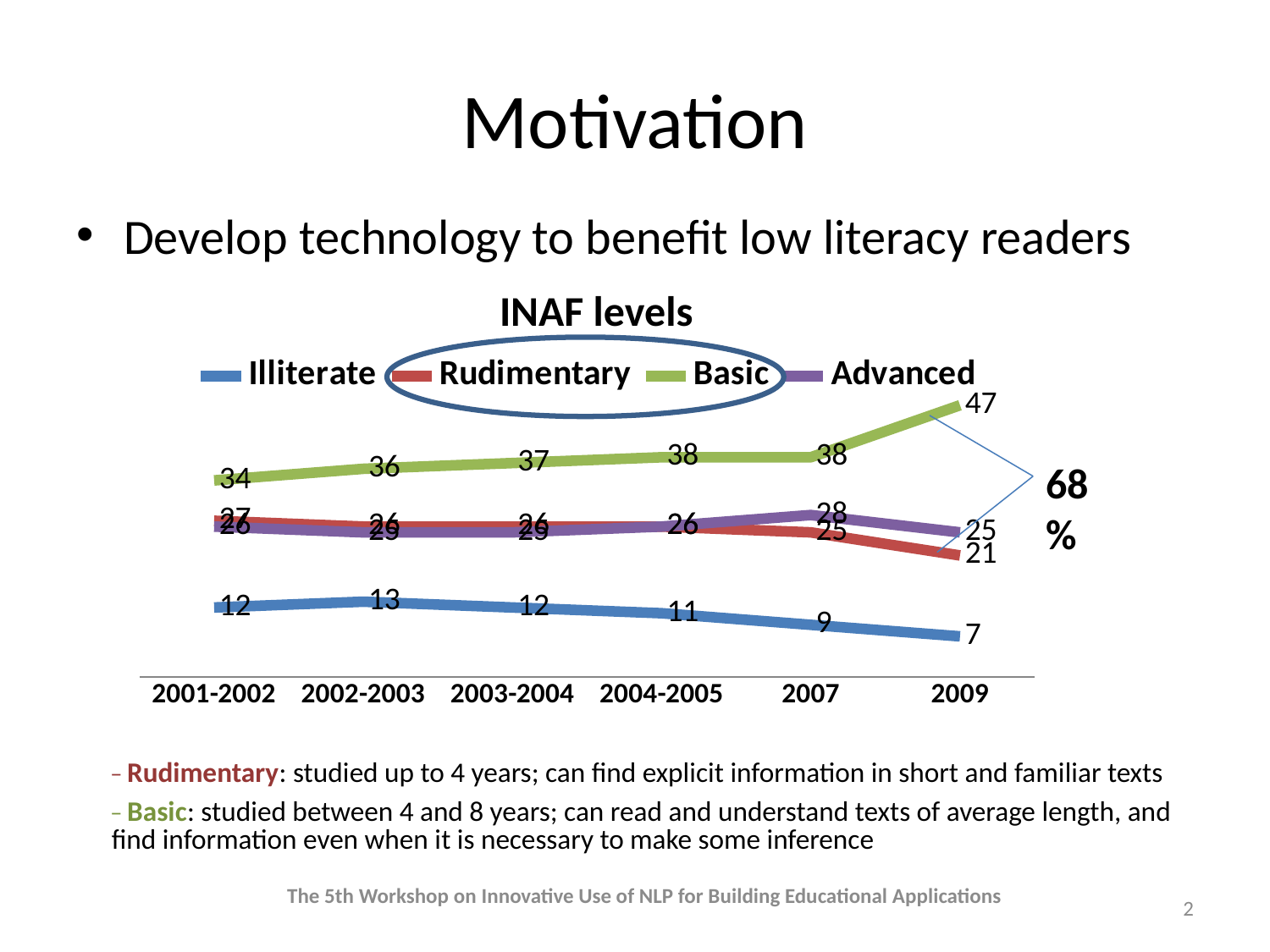
In which period does the Illiterate series reach its lowest value? 2009 What kind of chart is shown under the title "INAF levels"? line chart What is the value of the Rudimentary series in 2009? 21 In which period does the Basic series reach its highest value? 2009 What is the value of the Basic series in 2009? 47 How many time periods are shown on the x axis of the INAF levels chart? 6 Which series has the larger value in 2009, Basic or Illiterate? Basic Does the Illiterate series rise or fall from 2004-2005 to 2009? fall By how much did the Basic series increase from 2001-2002 to 2009? 13 How many series does the legend of the INAF levels chart list? 4 What is the value of the Illiterate series in 2007? 9 What is the value of the Illiterate series in 2009? 7